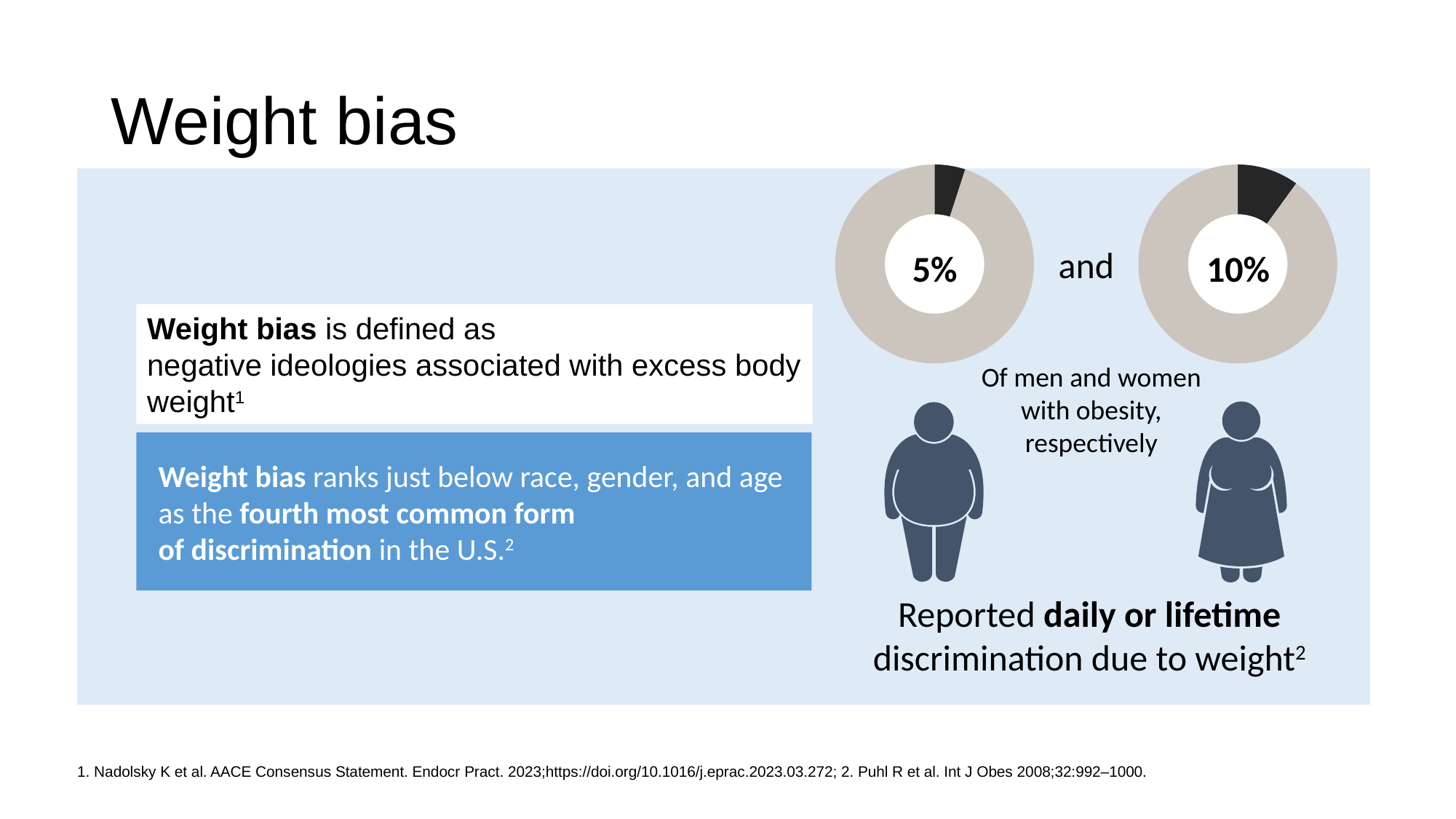
Is the value shown in the right donut chart (women) greater or less than the value in the left donut chart (men)? greater What do the two donut charts on the slide represent? Men and women with obesity who reported daily or lifetime discrimination due to weight What percentage of men with obesity reported daily or lifetime discrimination due to weight, according to the left donut chart? 5% What kind of chart is used to show the 5% and 10% values on the slide? Donut (pie) chart Which group shows the lower percentage reporting discrimination due to weight, men or women? Men What is the difference between the percentage of women and the percentage of men with obesity who reported discrimination due to weight? 5% How many donut charts are shown on the slide? 2 Which group shows the higher percentage reporting discrimination due to weight, men or women? Women What colour is the highlighted slice representing the reported percentage in each donut chart? Black What percentage of women with obesity reported daily or lifetime discrimination due to weight, according to the right donut chart? 10%